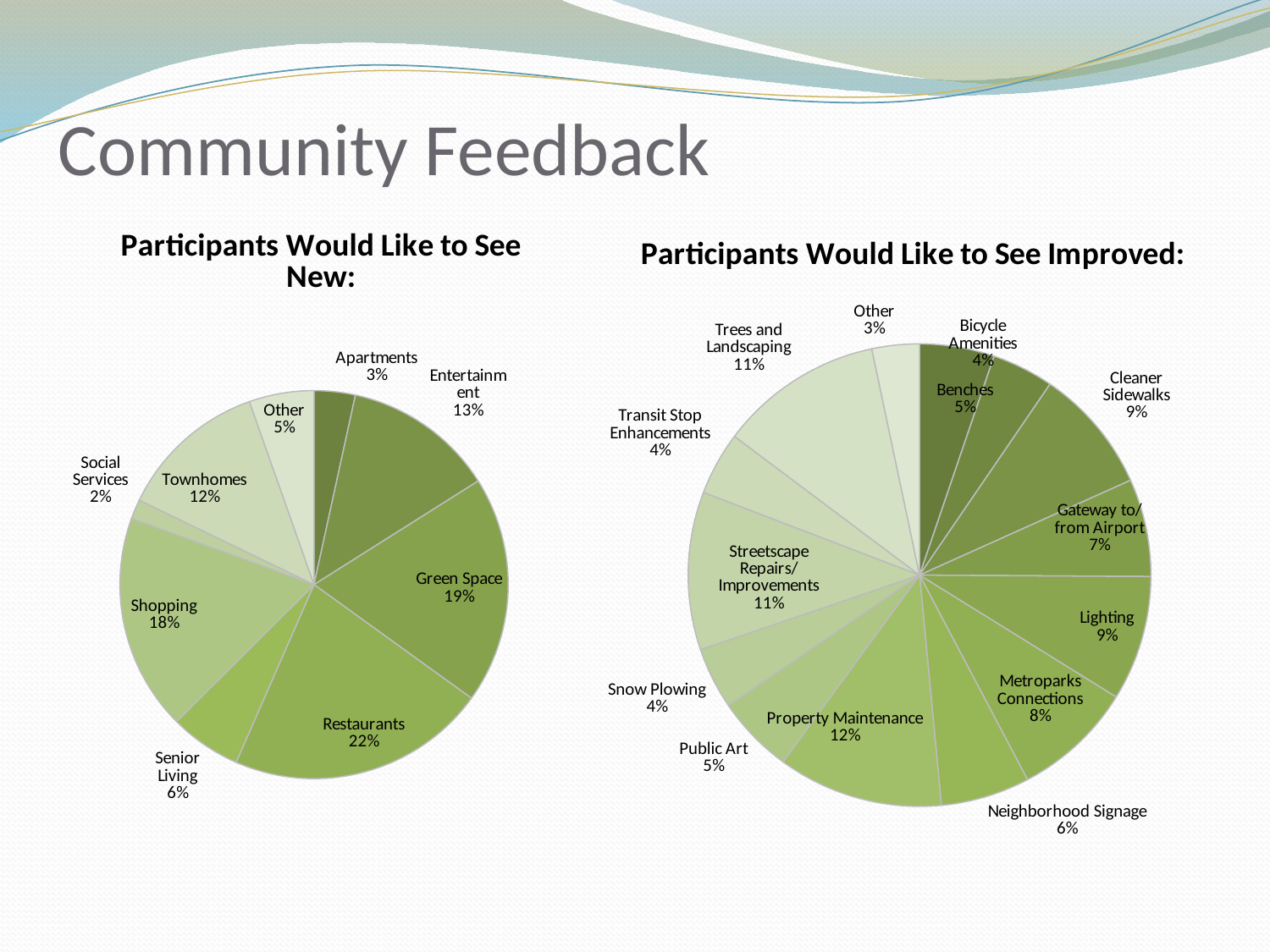
In the 'Participants Would Like to See Improved' chart, how many categories are shown? 14 In the 'Participants Would Like to See New' chart, which category has the smallest share? Social Services In the 'Participants Would Like to See New' chart, what is the difference between the Green Space and Shopping shares? 1% In the 'Participants Would Like to See New' chart, how many categories are shown? 9 What type of chart is used for 'Participants Would Like to See Improved'? Pie chart In the 'Participants Would Like to See New' chart, which category has the largest share? Restaurants In the 'Participants Would Like to See Improved' chart, which is larger: Cleaner Sidewalks or Gateway to/from Airport? Cleaner Sidewalks What is the title of the chart on the left side of the slide? Participants Would Like to See New: In the 'Participants Would Like to See New' chart, what share of participants chose Restaurants? 22% In the 'Participants Would Like to See Improved' chart, which category has the largest share? Property Maintenance In the 'Participants Would Like to See Improved' chart, what share of participants chose Property Maintenance? 12% In the 'Participants Would Like to See Improved' chart, which category has the smallest share? Other